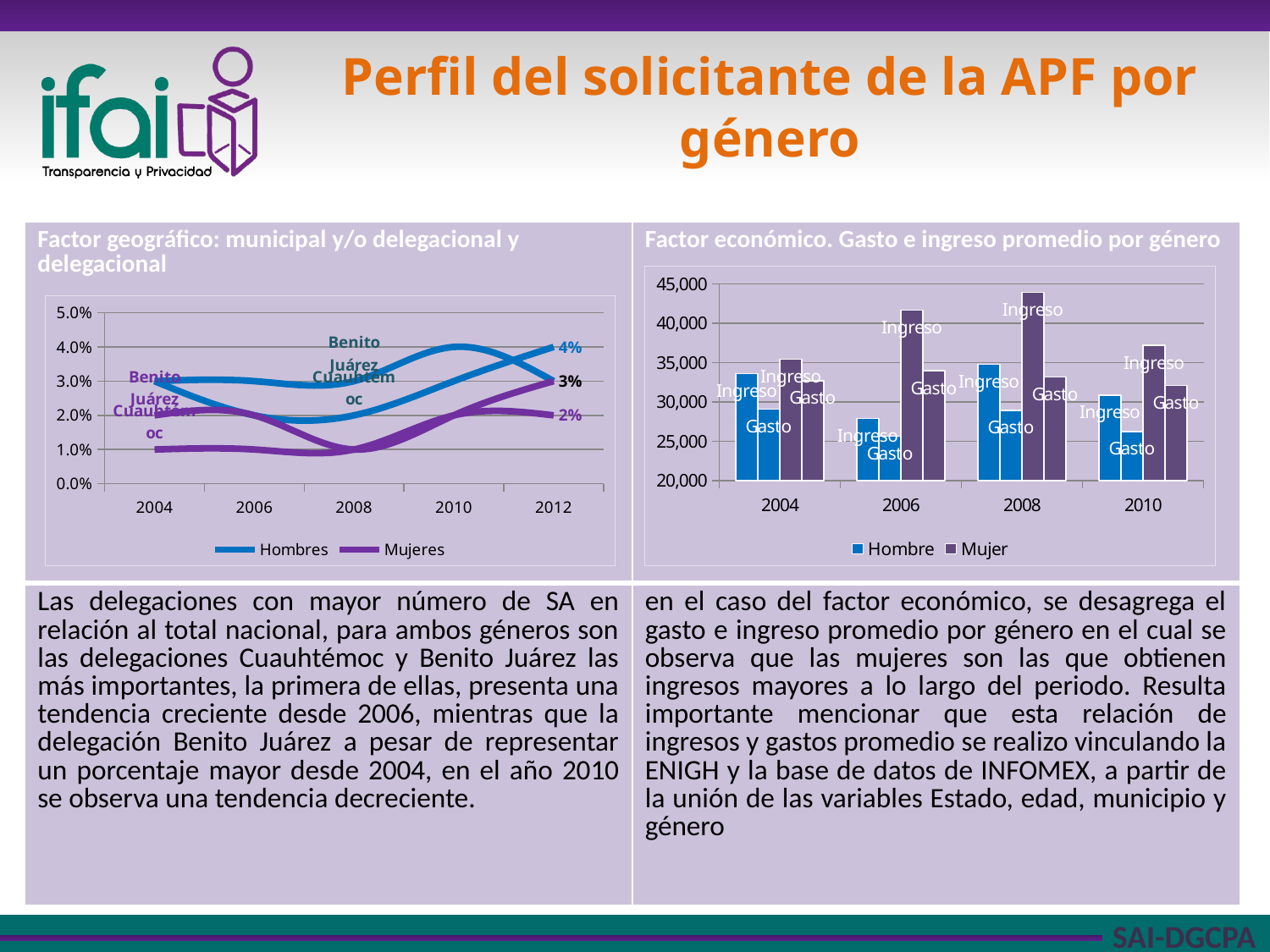
In the 'Factor económico' chart, is the Hombre Ingreso value for 2006 greater or less than 30,000? less How many series does the legend of the 'Factor económico' chart list? 2 What kind of chart is the 'Factor geográfico: municipal y/o delegacional y delegacional' chart? line chart How many years are shown on the x axis of the 'Factor geográfico' chart? 5 What are the legend entries of the 'Factor geográfico' chart? Hombres, Mujeres How many years are shown on the x axis of the 'Factor económico' chart? 4 In the 'Factor económico' chart, is the Mujer Ingreso value for 2008 greater or less than 40,000? greater In the 'Factor económico' chart, is the Hombre Gasto value for 2010 greater or less than 30,000? less What are the legend entries of the 'Factor económico' chart? Hombre, Mujer What kind of chart is the 'Factor económico. Gasto e ingreso promedio por género' chart? bar chart In the 'Factor económico' chart, for 2004, which is larger: the Hombre Ingreso bar or the Mujer Ingreso bar? Mujer Ingreso In the 'Factor económico' chart, in which year is the Mujer Ingreso bar the highest? 2008